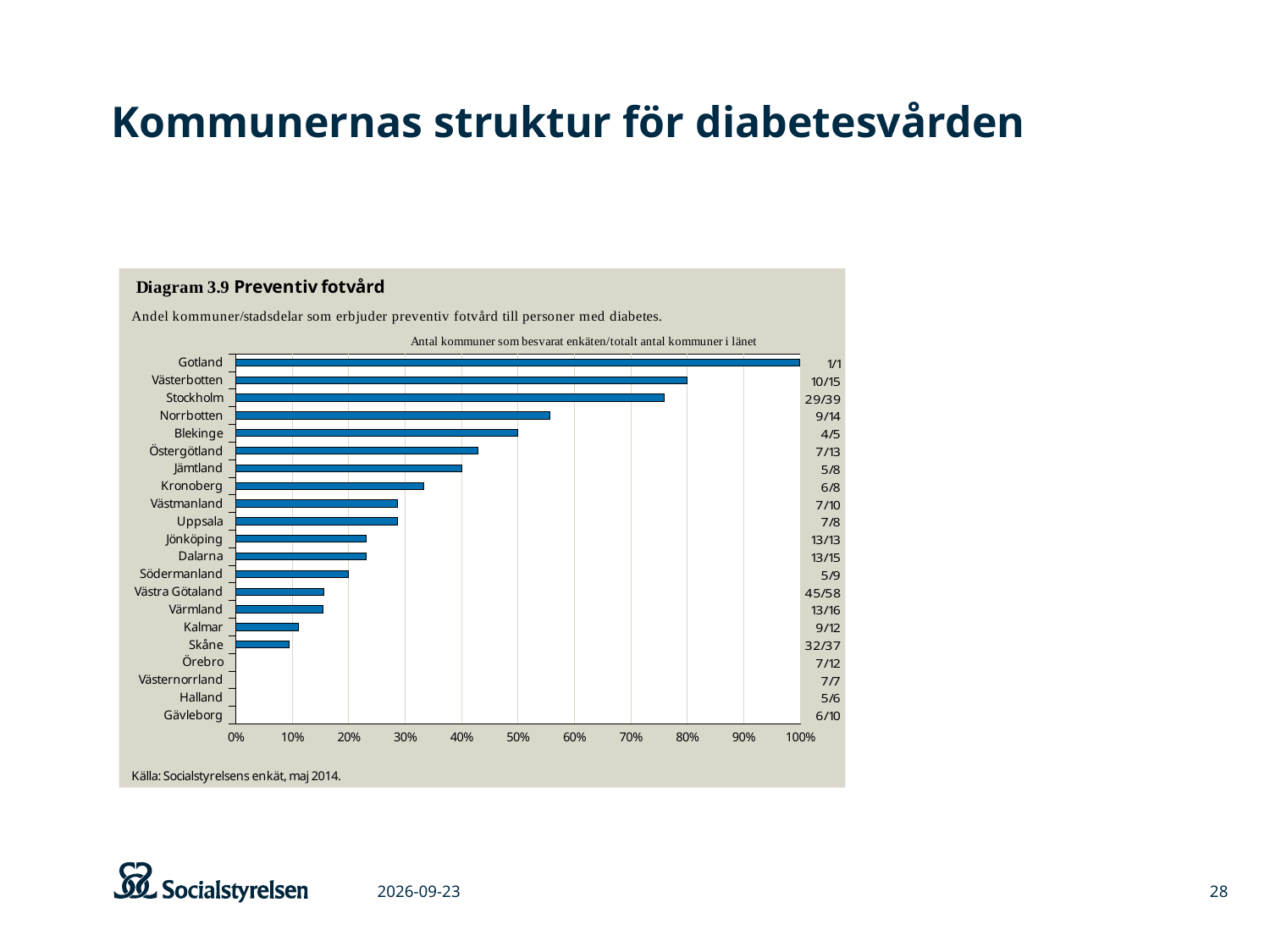
How many counties show no visible bar (0%) in the chart? 4 Is the value for Stockholm greater or less than 70%? greater What is the value shown for Gotland? 100% Is the value for Norrbotten greater or less than 60%? less What is the label printed to the right of the Västra Götaland bar (municipalities answering / total municipalities)? 45/58 Do the bar values increase or decrease going from the top of the chart to the bottom? decrease What kind of chart is Diagram 3.9 Preventiv fotvård? bar chart How many counties (categories) are listed on the y axis of the chart? 21 Is the value for Södermanland greater or less than 30%? less Which has a larger value, Stockholm or Norrbotten? Stockholm Which county has the highest share of municipalities offering preventive foot care? Gotland